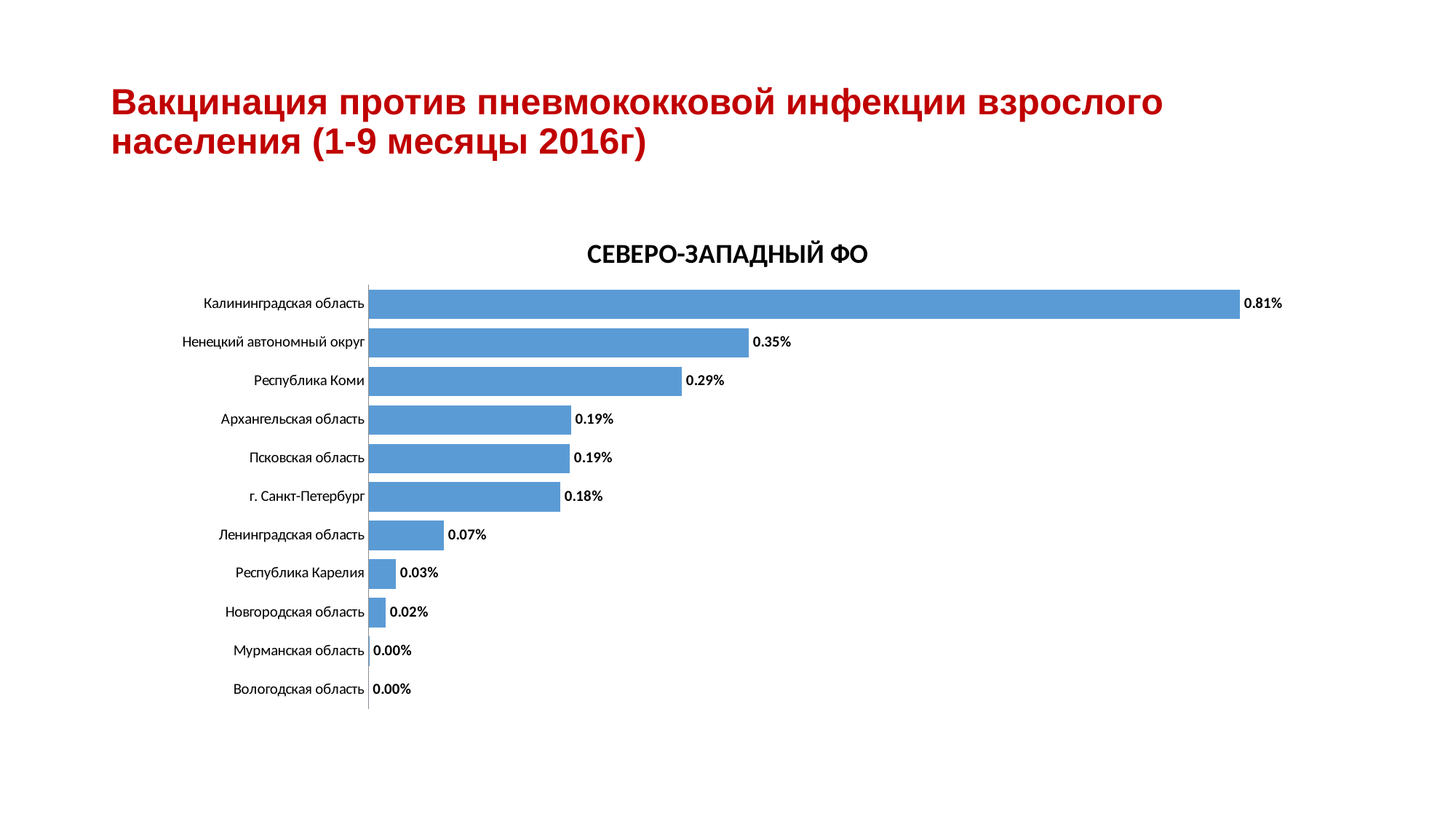
What is the value for г. Санкт-Петербург? 0.18% What is the title of the chart? СЕВЕРО-ЗАПАДНЫЙ ФО What kind of chart is shown on the slide? Bar chart Which is larger, the value for Ненецкий автономный округ or the value for Республика Коми? Ненецкий автономный округ What is the difference between the values for Калининградская область and Ненецкий автономный округ? 0.46% What is the value for Калининградская область? 0.81% What is the difference between the values for Республика Коми and Архангельская область? 0.10% Which region has the highest value? Калининградская область What is the value for Республика Коми? 0.29% How many regions are shown in the chart? 11 Which is larger, the value for Республика Карелия or the value for Новгородская область? Республика Карелия What is the value for Ленинградская область? 0.07%